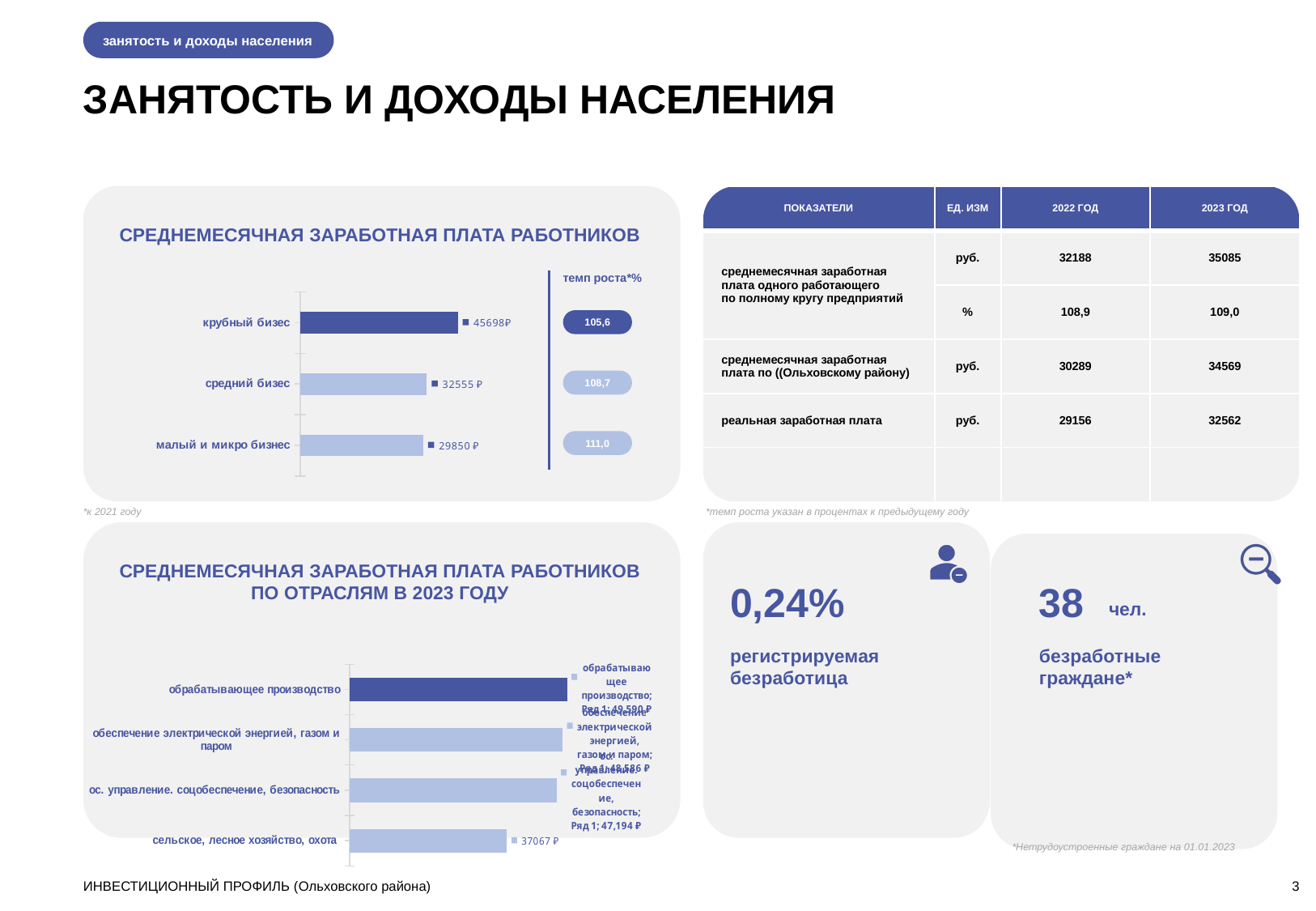
In the chart 'СРЕДНЕМЕСЯЧНАЯ ЗАРАБОТНАЯ ПЛАТА РАБОТНИКОВ', which category has the highest value? крубный бизес In the chart 'СРЕДНЕМЕСЯЧНАЯ ЗАРАБОТНАЯ ПЛАТА РАБОТНИКОВ', what is the value for 'крубный бизес'? 45698₽ In the chart 'СРЕДНЕМЕСЯЧНАЯ ЗАРАБОТНАЯ ПЛАТА РАБОТНИКОВ ПО ОТРАСЛЯМ В 2023 ГОДУ', how many categories are shown? 4 In the chart 'СРЕДНЕМЕСЯЧНАЯ ЗАРАБОТНАЯ ПЛАТА РАБОТНИКОВ ПО ОТРАСЛЯМ В 2023 ГОДУ', which category has the highest value? обрабатывающее производство In the chart 'СРЕДНЕМЕСЯЧНАЯ ЗАРАБОТНАЯ ПЛАТА РАБОТНИКОВ', what is the value for 'средний бизес'? 32555 ₽ What kind of chart is 'СРЕДНЕМЕСЯЧНАЯ ЗАРАБОТНАЯ ПЛАТА РАБОТНИКОВ'? bar chart In the chart 'СРЕДНЕМЕСЯЧНАЯ ЗАРАБОТНАЯ ПЛАТА РАБОТНИКОВ', what is the difference between the values for 'крубный бизес' and 'средний бизес'? 13143 In the chart 'СРЕДНЕМЕСЯЧНАЯ ЗАРАБОТНАЯ ПЛАТА РАБОТНИКОВ ПО ОТРАСЛЯМ В 2023 ГОДУ', which category has the lowest value? сельское, лесное хозяйство, охота In the chart 'СРЕДНЕМЕСЯЧНАЯ ЗАРАБОТНАЯ ПЛАТА РАБОТНИКОВ', which category has the lowest value? малый и микро бизнес In the chart 'СРЕДНЕМЕСЯЧНАЯ ЗАРАБОТНАЯ ПЛАТА РАБОТНИКОВ', how many categories are shown? 3 In the chart 'СРЕДНЕМЕСЯЧНАЯ ЗАРАБОТНАЯ ПЛАТА РАБОТНИКОВ', what is the value for 'малый и микро бизнес'? 29850 ₽ In the chart 'СРЕДНЕМЕСЯЧНАЯ ЗАРАБОТНАЯ ПЛАТА РАБОТНИКОВ ПО ОТРАСЛЯМ В 2023 ГОДУ', what is the value for 'сельское, лесное хозяйство, охота'? 37067 ₽